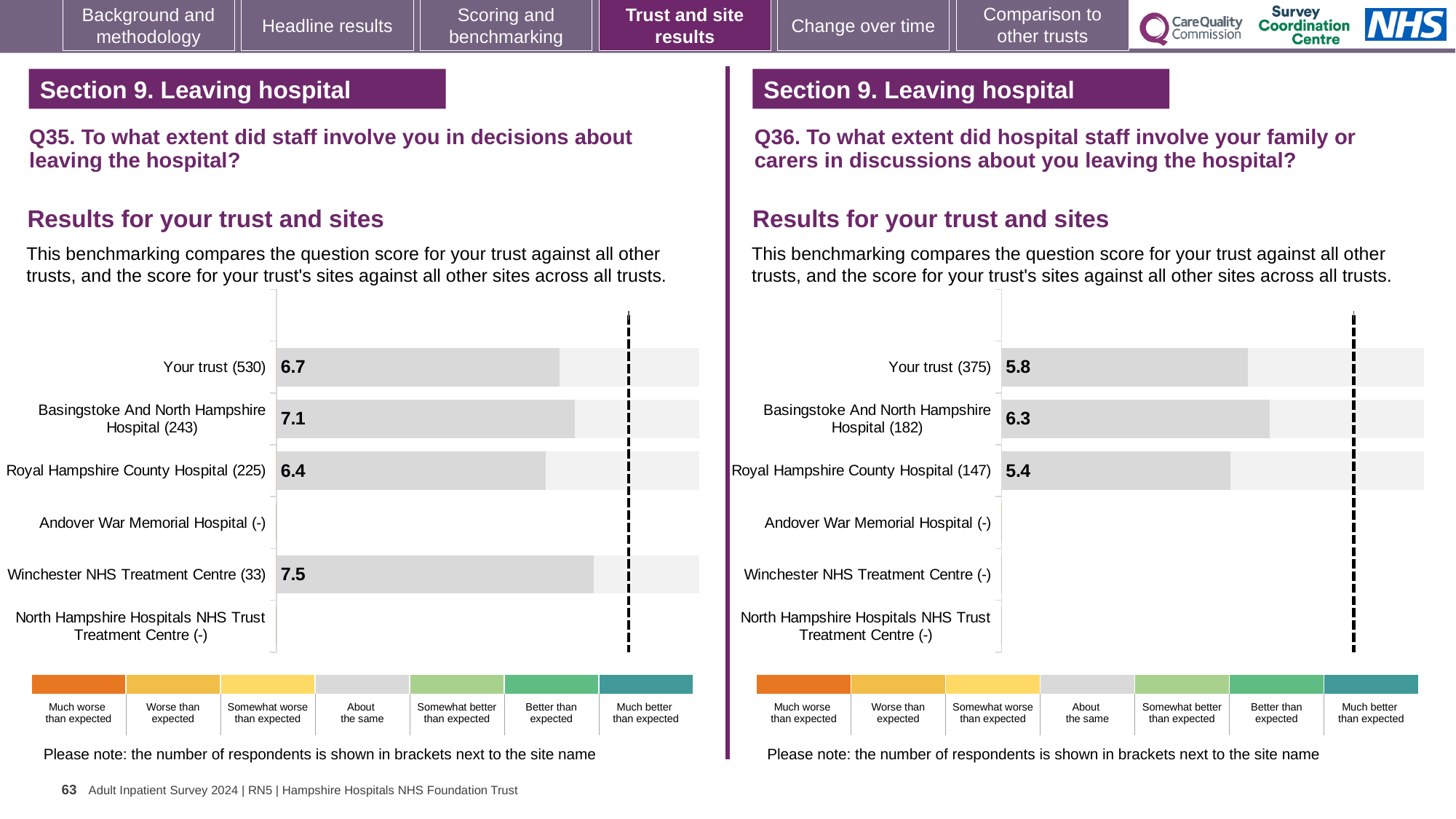
On the Q36 chart (right), what is the difference between the scores for Basingstoke And North Hampshire Hospital (182) and Your trust (375)? 0.5 On the Q35 chart (left), which site with a score shown has the lowest score? Royal Hampshire County Hospital (225) On the Q35 chart (left), which site has the highest score? Winchester NHS Treatment Centre (33) What kind of chart is the Q36 chart (right)? Bar chart On the Q35 chart (left), what is the score for Winchester NHS Treatment Centre (33)? 7.5 On the Q36 chart (right), what is the score for Your trust (375)? 5.8 On the Q35 chart (left), what is the difference between the scores for Basingstoke And North Hampshire Hospital (243) and Royal Hampshire County Hospital (225)? 0.7 On the Q36 chart (right), what is the score for Royal Hampshire County Hospital (147)? 5.4 On the Q36 chart (right), which is larger: the score for Your trust (375) or for Basingstoke And North Hampshire Hospital (182)? Basingstoke And North Hampshire Hospital (182) How many site/trust categories are listed on the Q35 chart (left)? 6 On the Q35 chart (left), what is the score for Your trust (530)? 6.7 On the Q36 chart (right), which site has the highest score? Basingstoke And North Hampshire Hospital (182)